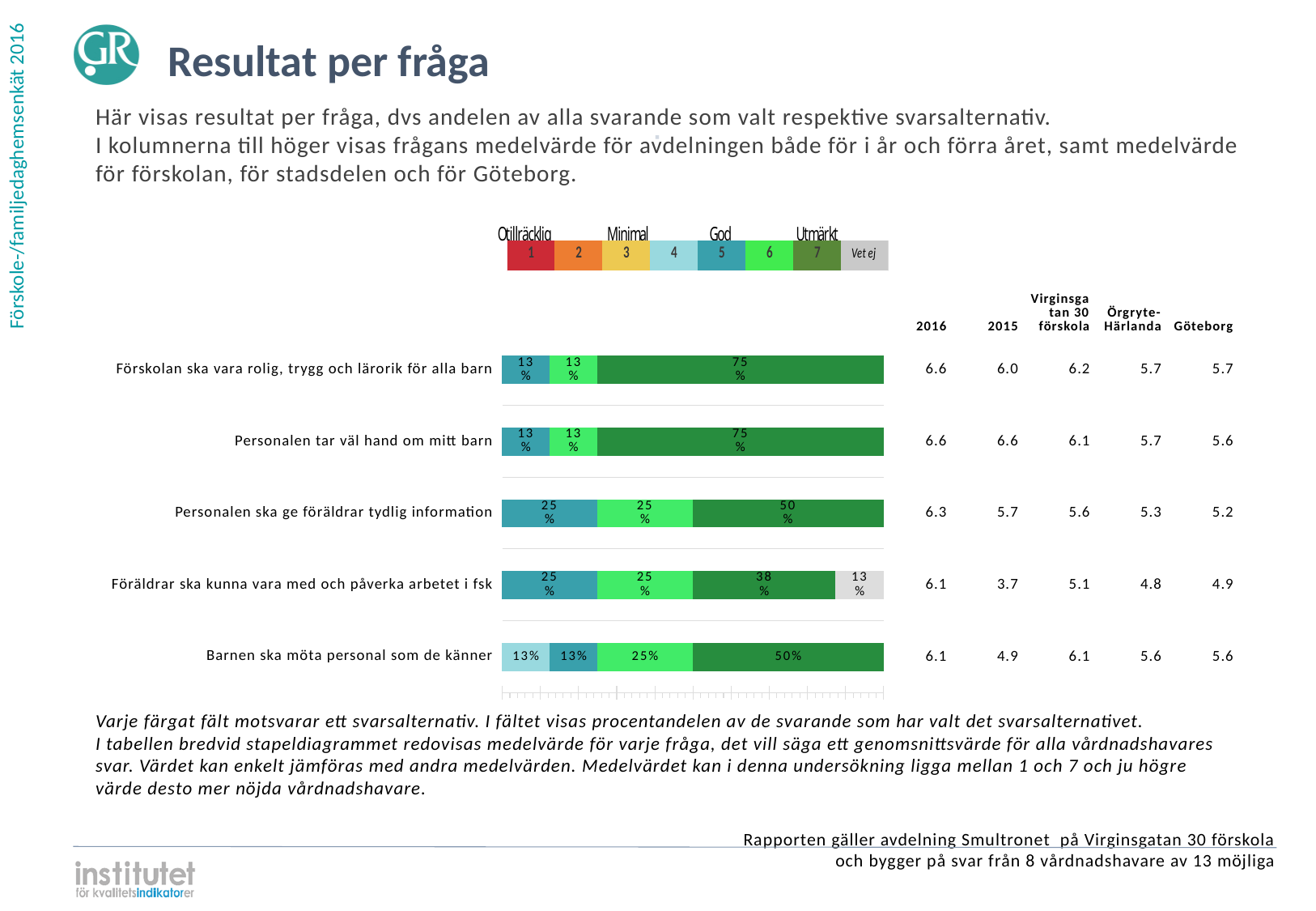
What is the share of the dark green (7) segment for 'Barnen ska möta personal som de känner'? 50% What is the Göteborg mean value for 'Personalen tar väl hand om mitt barn'? 5.6 What is the 2016 mean value for 'Personalen ska ge föräldrar tydlig information'? 6.3 Which question has the largest share of respondents giving the highest rating (7)? Förskolan ska vara rolig, trygg och lärorik för alla barn (tied with Personalen tar väl hand om mitt barn) What percentage of respondents chose the highest rating (7, dark green) for 'Förskolan ska vara rolig, trygg och lärorik för alla barn'? 75% What is the 2015 mean value for 'Föräldrar ska kunna vara med och påverka arbetet i fsk'? 3.7 How many questions (categories) are shown in the bar chart? 5 Which is larger for 'Barnen ska möta personal som de känner': the 2016 mean or the 2015 mean? 2016 mean (6.1) What kind of chart is used to show the share of respondents per answer alternative? Stacked bar chart How many entries does the colour legend above the chart list? 8 What is the difference between the dark green (7) share for 'Personalen ska ge föräldrar tydlig information' and for 'Föräldrar ska kunna vara med och påverka arbetet i fsk'? 12 percentage points What percentage of respondents answered 'Vet ej' for 'Föräldrar ska kunna vara med och påverka arbetet i fsk'? 13%